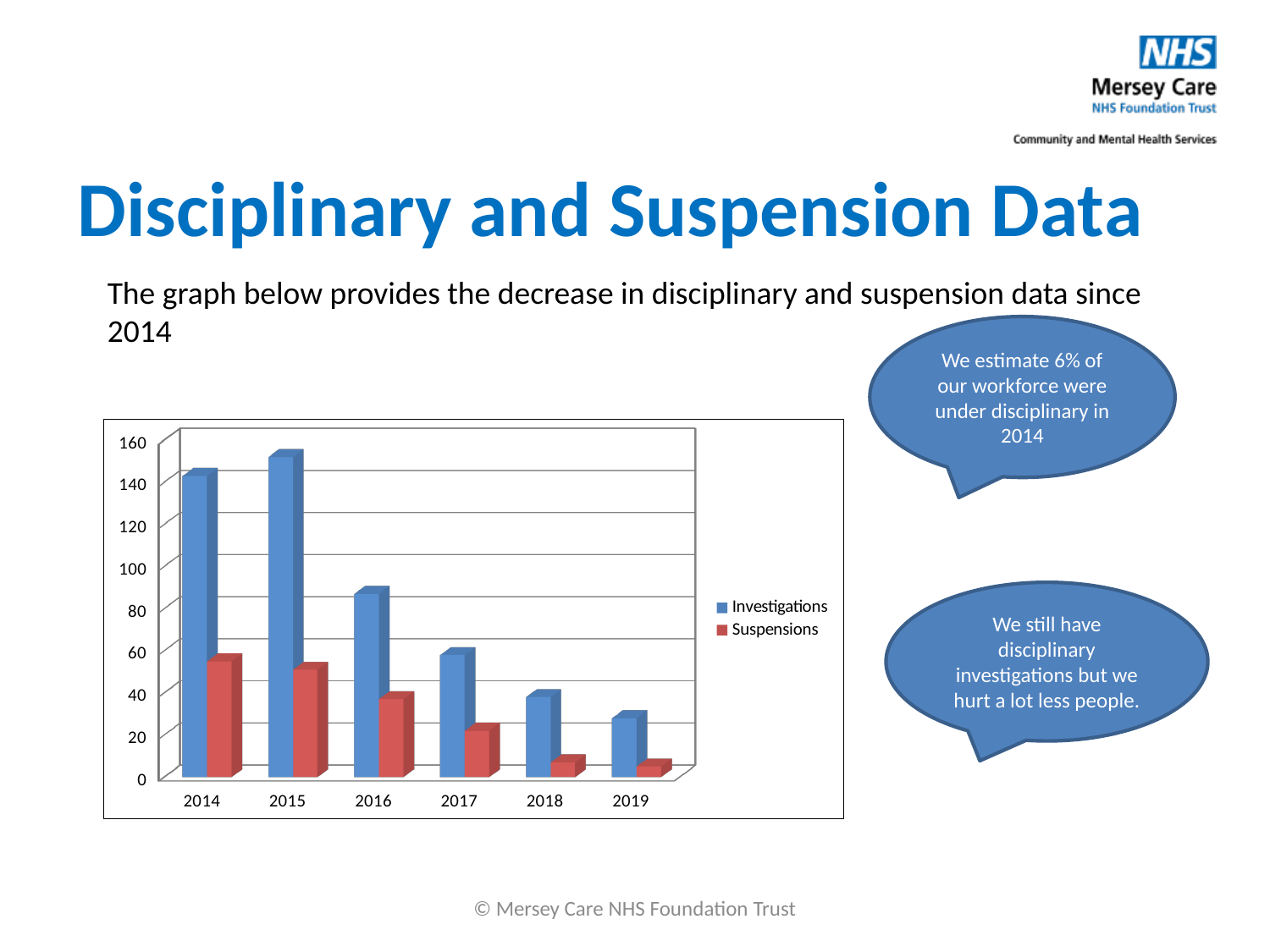
Is the value for Investigations in 2015 greater or less than 140? greater Is the value for Investigations in 2016 greater or less than 80? greater Do the Suspensions values rise or fall from 2014 to 2019? fall How many series does the legend list? 2 In 2014, which is larger, Investigations or Suspensions? Investigations Is the value for Suspensions in 2018 greater or less than 20? less Which year has the highest value for Investigations? 2015 Which year has the lowest value for Investigations? 2019 How many years are shown on the x axis? 6 What kind of chart is shown on the slide? bar chart Which series is shown in red? Suspensions